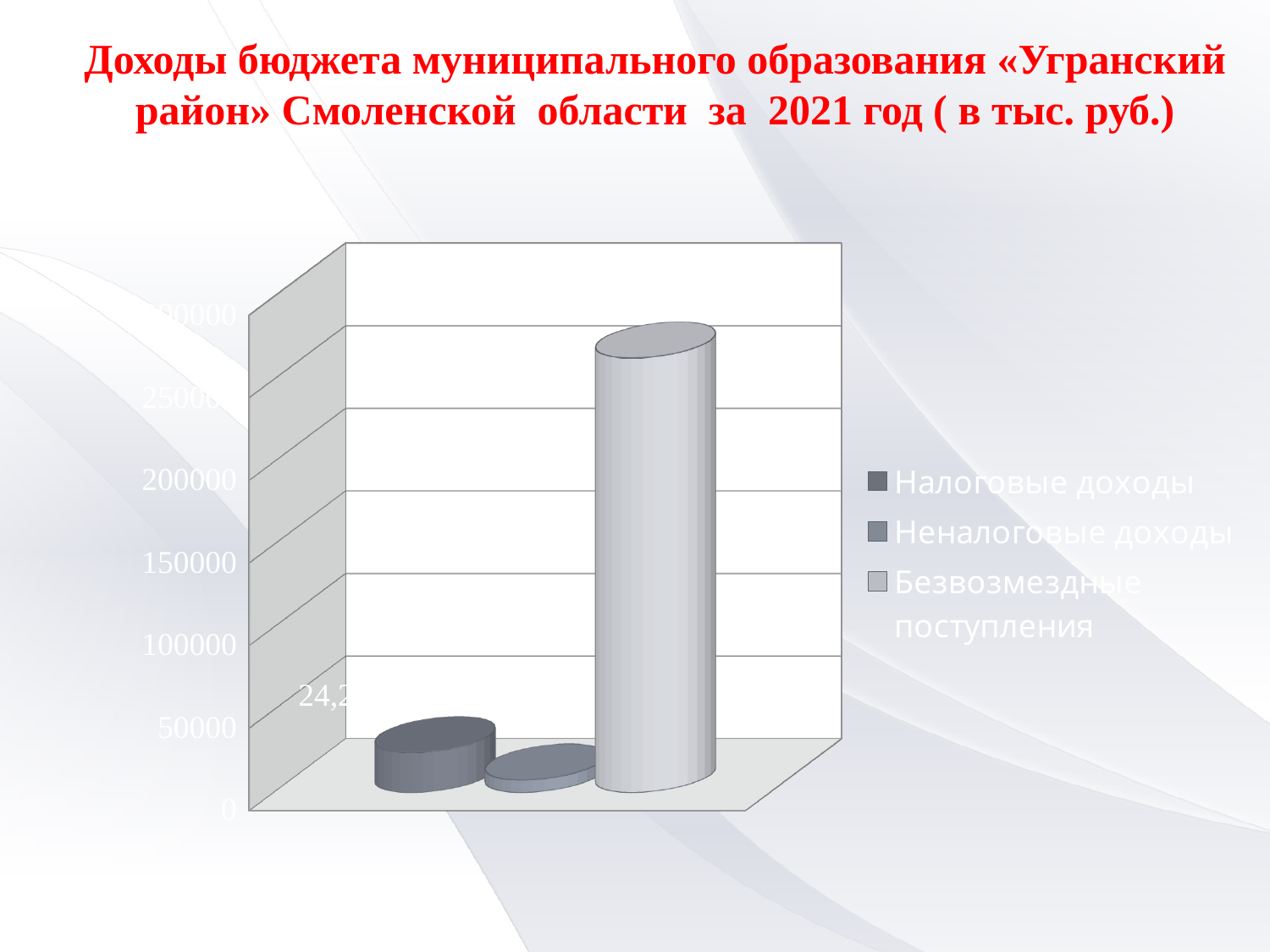
What kind of chart is shown on the slide? bar chart Is the value for Безвозмездные поступления greater or less than 250000? greater In what units are the values on the slide expressed, according to the title? тыс. руб. Which series has the highest value? Безвозмездные поступления How many bars are plotted in the chart? 3 Is the value for Безвозмездные поступления greater or less than 300000? less Which series has the lowest value? Неналоговые доходы Is the value for Неналоговые доходы greater or less than 50000? less Which is larger, Налоговые доходы or Неналоговые доходы? Налоговые доходы Which is larger, Безвозмездные поступления or Налоговые доходы? Безвозмездные поступления How many series does the legend list? 3